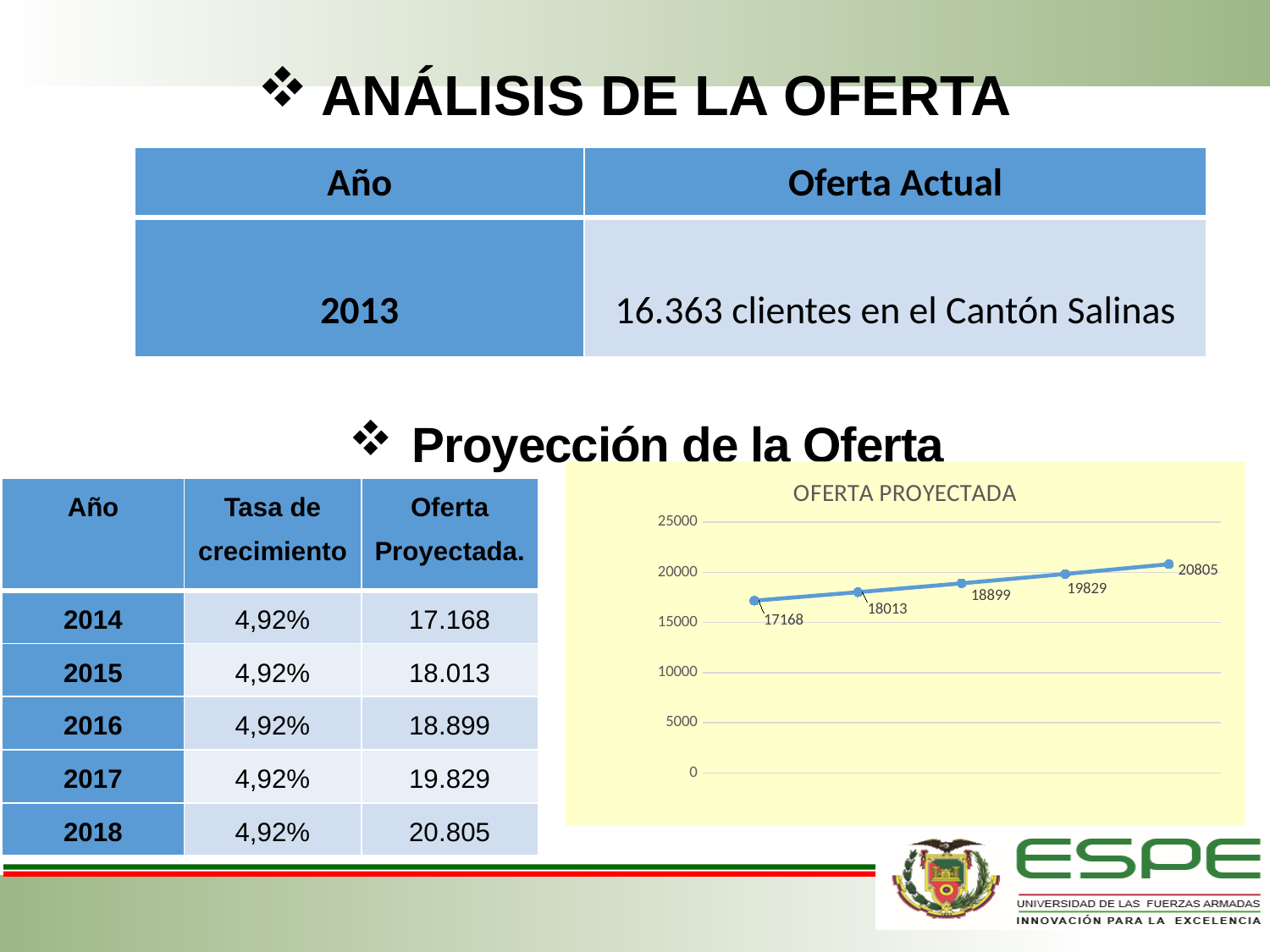
What is the highest value plotted on the OFERTA PROYECTADA chart? 20805 What type of chart is shown under "Proyección de la Oferta"? line chart Is the value of the last point on the OFERTA PROYECTADA chart greater or less than 20000? greater Which is larger on the OFERTA PROYECTADA chart, the second point (18013) or the fourth point (19829)? 19829 What is the value of the third point on the OFERTA PROYECTADA chart? 18899 What is the value of the last (rightmost) point on the OFERTA PROYECTADA chart? 20805 How many data points are plotted on the OFERTA PROYECTADA line? 5 What is the value of the first (leftmost) point on the OFERTA PROYECTADA chart? 17168 What is the difference between the last and the first point on the OFERTA PROYECTADA chart? 3637 What is the title of the chart on the slide? OFERTA PROYECTADA What is the lowest value plotted on the OFERTA PROYECTADA chart? 17168 Do the values on the OFERTA PROYECTADA chart rise or fall from left to right? rise